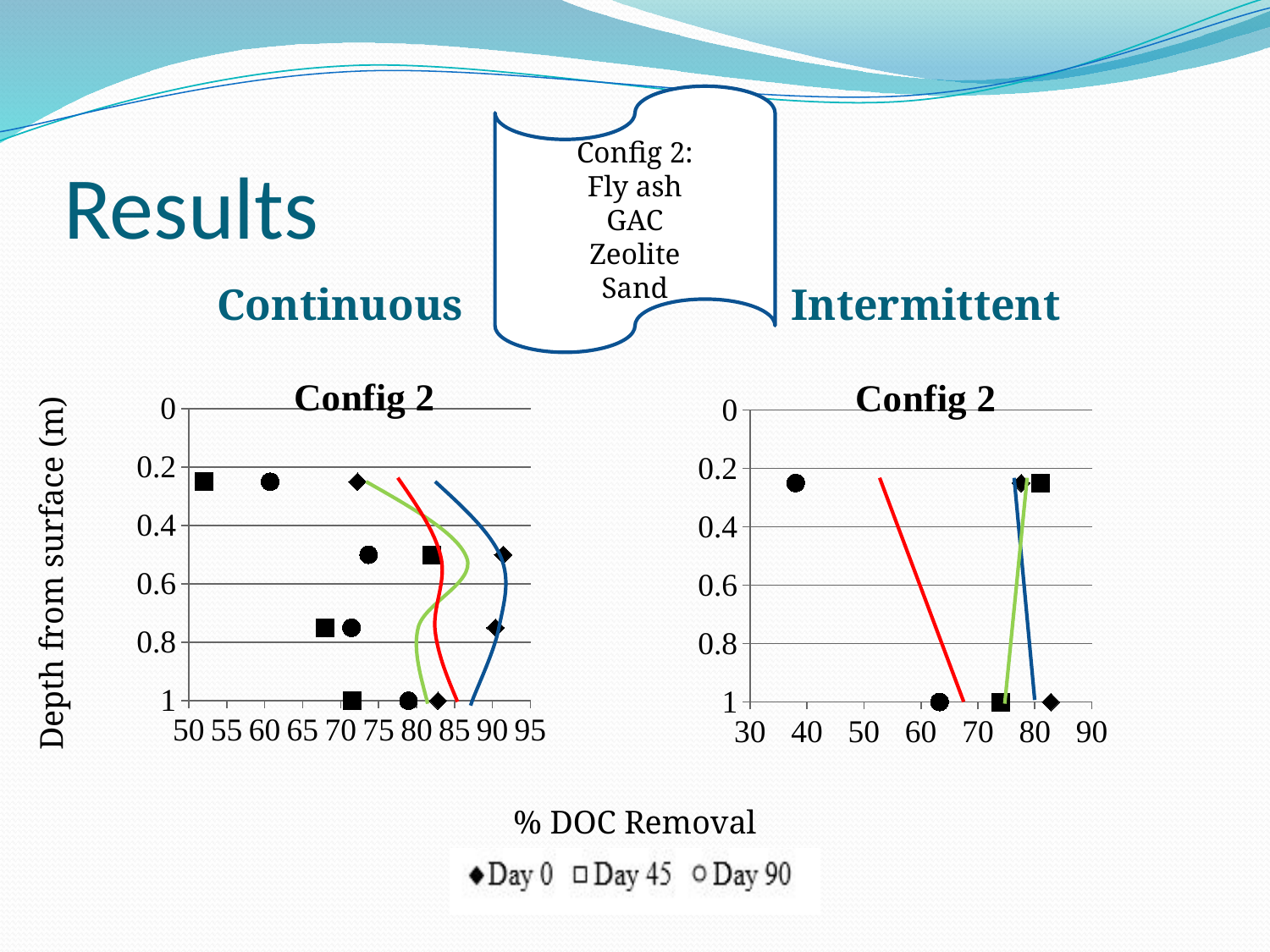
In the Continuous Config 2 chart on the left, at the shallowest depth, which is larger: the Day 0 value or the Day 45 value? Day 0 What is the x-axis label shared by the two charts? % DOC Removal In the Intermittent Config 2 chart on the right, is the Day 0 value at depth 1 greater or less than 80? greater What kind of chart is the Continuous Config 2 chart on the left? scatter chart In the Intermittent Config 2 chart on the right, is the Day 90 value at the shallowest depth greater or less than 50? less In the Intermittent Config 2 chart on the right, at the shallowest depth, which is larger: the Day 90 value or the Day 0 value? Day 0 In the Continuous Config 2 chart on the left, is the Day 0 value at depth 0.5 greater or less than 90? greater In the Continuous Config 2 chart on the left, how many depth points are plotted for the Day 0 series? 4 What are the series names in the legend? Day 0, Day 45, Day 90 In the Intermittent Config 2 chart on the right, does the Day 90 % DOC removal increase or decrease from the shallowest depth to depth 1? increase How many series does the legend list for the charts? 3